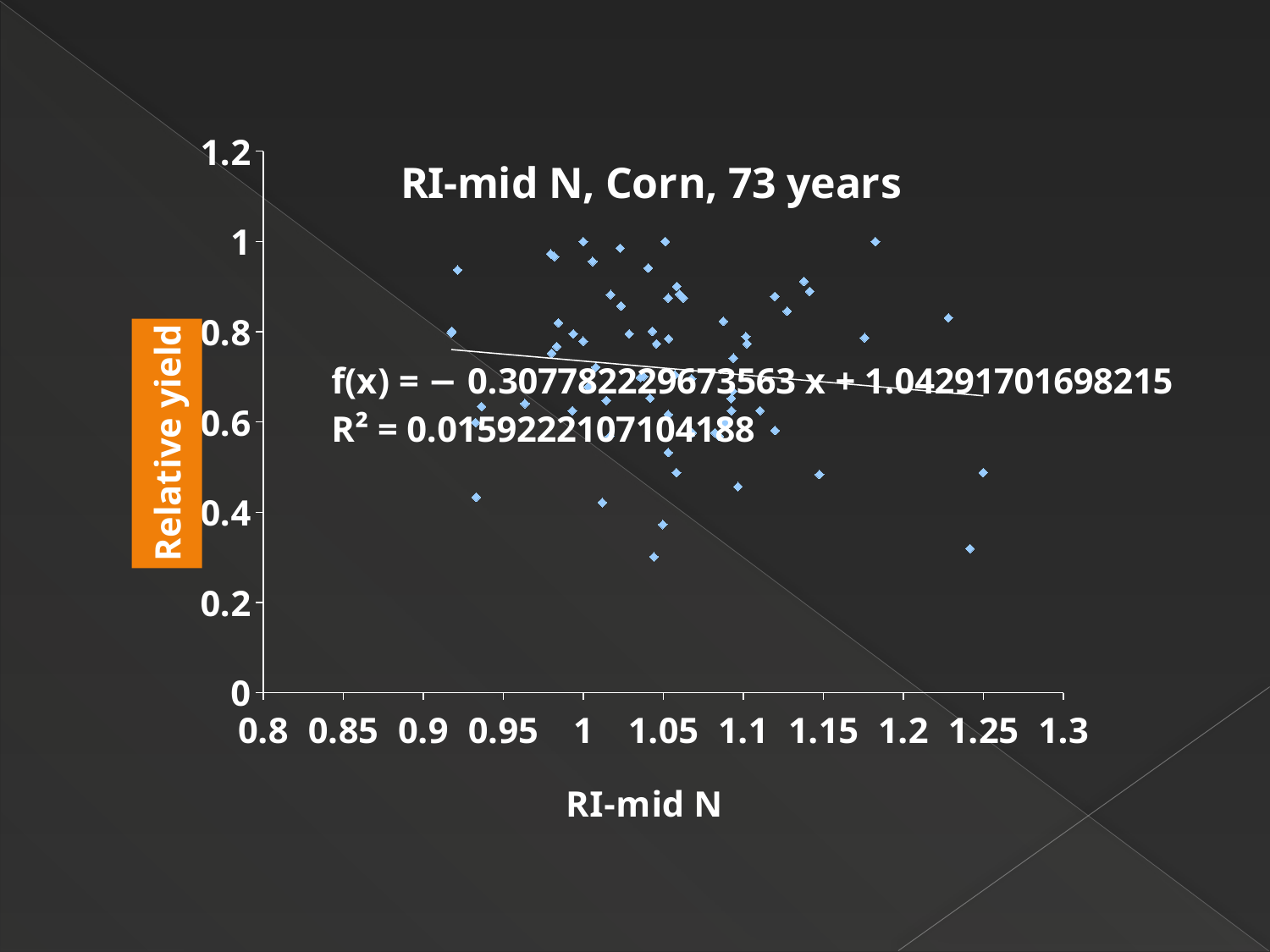
Is the highest relative yield plotted greater or less than 0.8? greater What is the maximum value shown on the y axis? 1.2 What is the slope of the fitted line f(x) shown on the chart? −0.307782229673563 What is the label of the y axis? Relative yield What is the title of the chart? RI-mid N, Corn, 73 years Does the trendline rise or fall as RI-mid N increases? fall What is the intercept of the fitted line f(x) shown on the chart? 1.04291701698215 What is the R² value shown for the trendline? 0.0159222107104188 What is the minimum value shown on the x axis? 0.8 What kind of chart is shown on the slide? scatter plot Is the relative yield of the point at about RI-mid N 1.25 near the bottom of the chart greater or less than 0.4? less Is the lowest relative yield plotted greater or less than 0.4? less